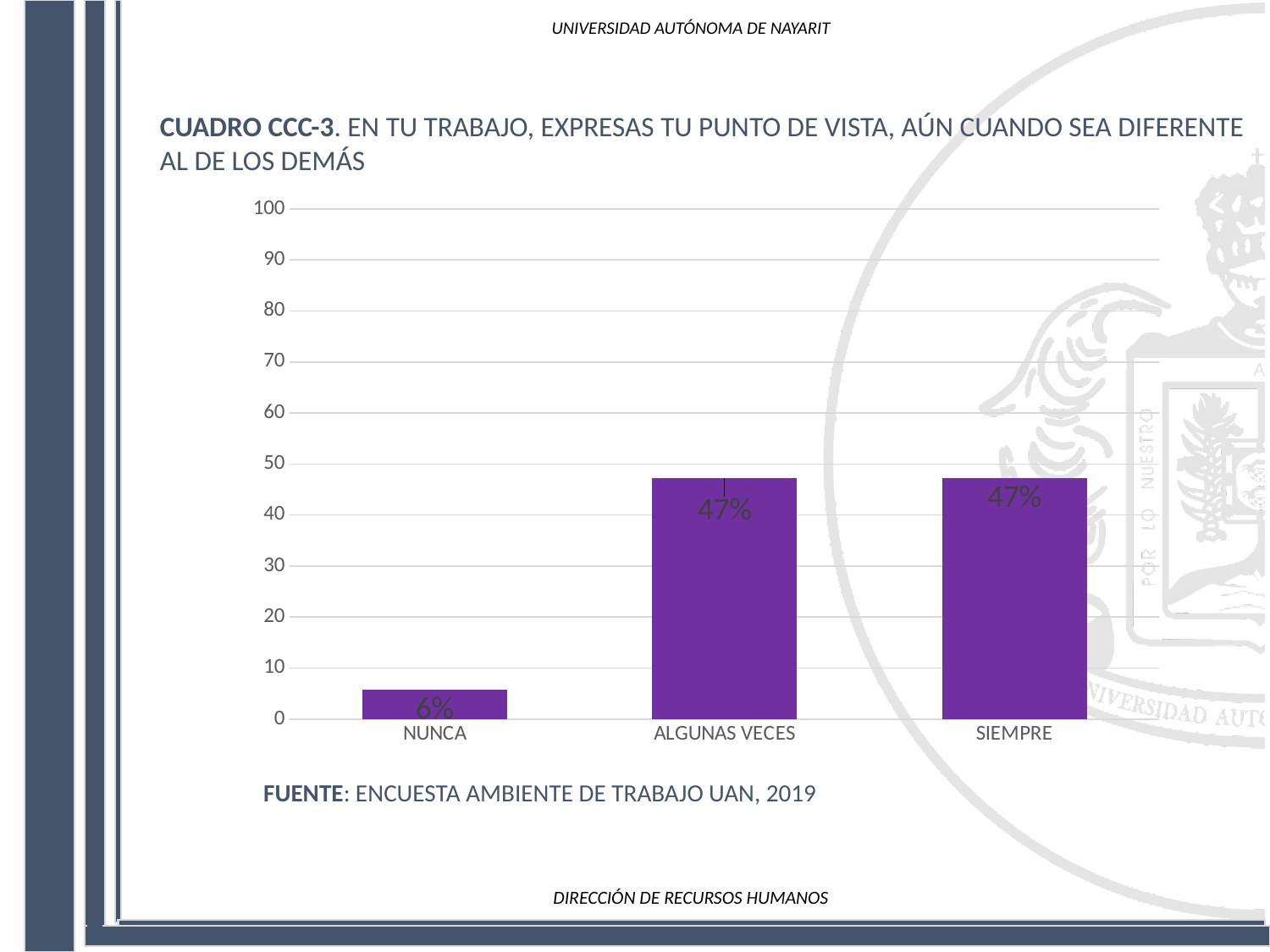
What is the value for SIEMPRE? 47% How many categories are shown on the x axis? 3 Which is larger, the value for SIEMPRE or the value for NUNCA? SIEMPRE What is the highest value shown on the y axis? 100 What is the difference between the values for ALGUNAS VECES and NUNCA? 41% Is the value for NUNCA greater or less than 10? less What is the value for NUNCA? 6% What kind of chart is shown on the slide? bar chart What is the source cited below the chart? ENCUESTA AMBIENTE DE TRABAJO UAN, 2019 Is the value for ALGUNAS VECES greater or less than 50? less Which category has the lowest value? NUNCA What is the value for ALGUNAS VECES? 47%